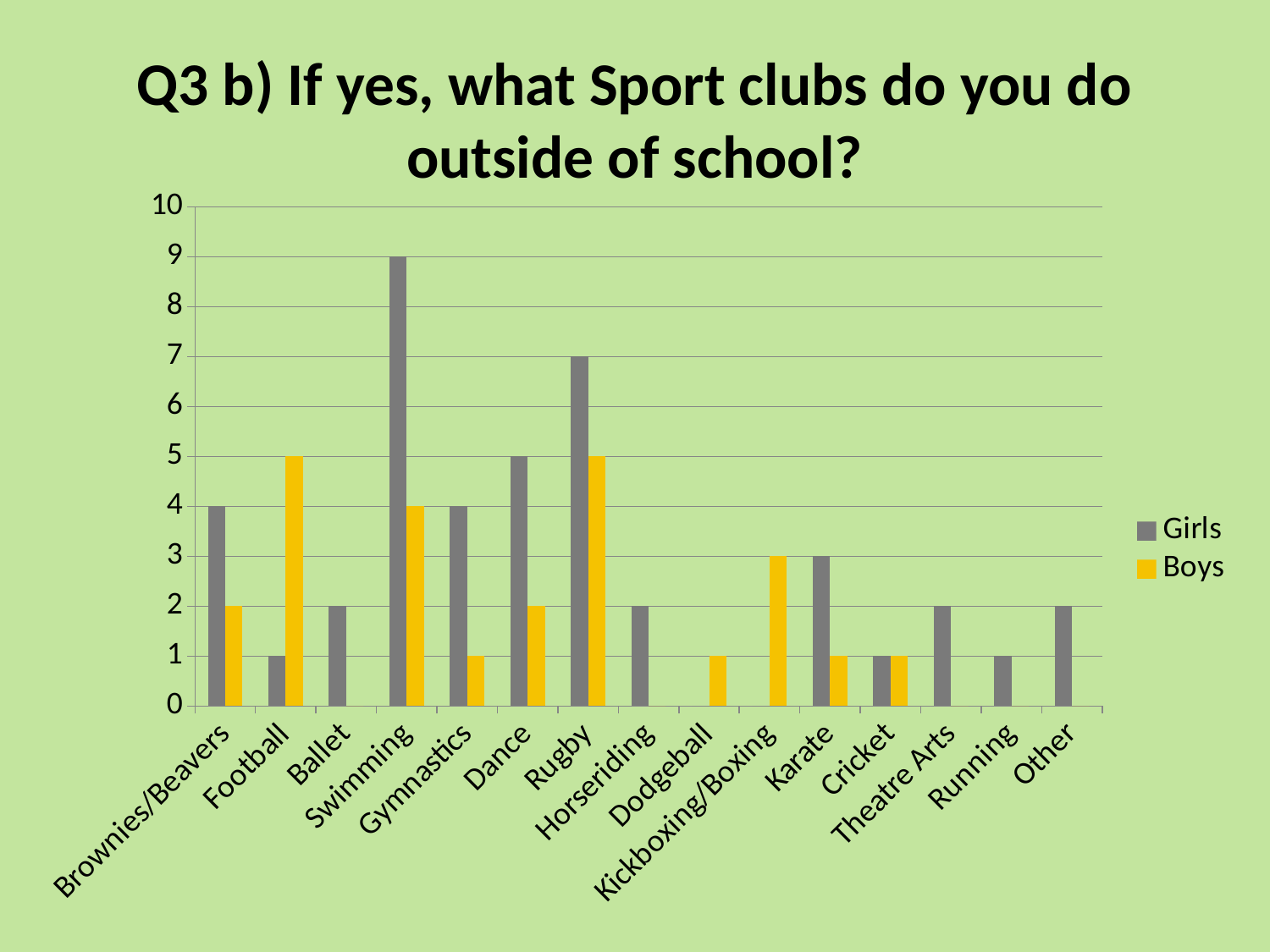
What is the Girls value for Swimming? 9 What is the difference between the Girls and Boys values for Swimming? 5 What is the Girls value for Rugby? 7 How many categories are shown on the x axis? 15 What kind of chart is shown on the slide? Bar chart What colour represents Boys in the chart? Yellow Which category has the highest Boys value? Football and Rugby How many series does the legend list? 2 Is the Girls value for Swimming greater or less than 8? greater Which category has the highest Girls value? Swimming Which is larger for Football, the Girls value or the Boys value? Boys What is the Boys value for Football? 5